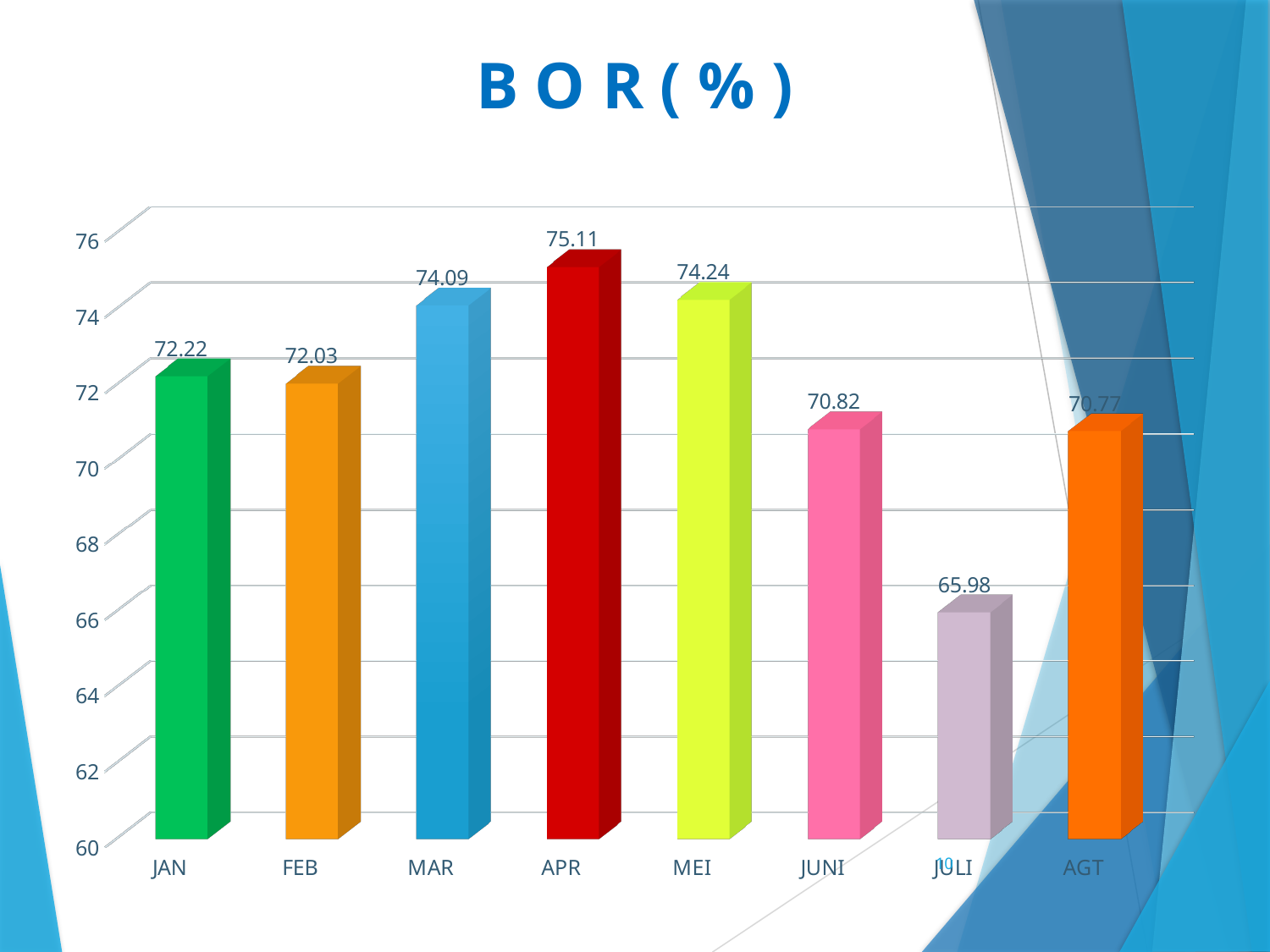
What is the difference between the BOR (%) values for APR and JULI? 9.13 What kind of chart is shown on the slide? bar chart What is the BOR (%) value for APR? 75.11 Which has a higher BOR (%), MAR or MEI? MEI What is the BOR (%) value for JULI? 65.98 Is the BOR (%) value for JUNI greater or less than 72? less What is the difference between the BOR (%) values for MEI and JUNI? 3.42 What is the BOR (%) value for MAR? 74.09 What is the title of the chart? B O R ( % ) Which month has the lowest BOR (%)? JULI Which month has the highest BOR (%)? APR How many months are shown on the chart? 8